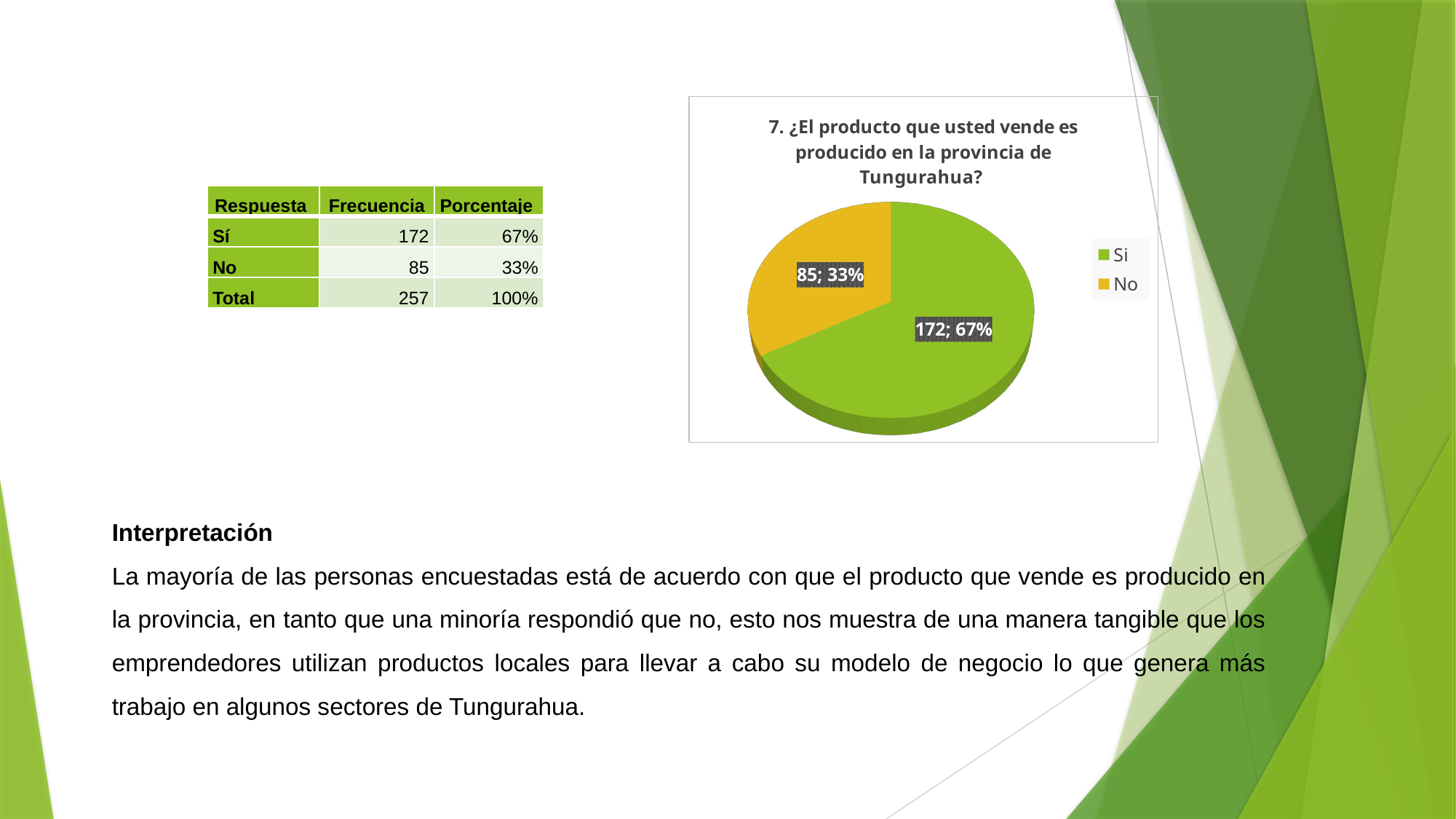
What share of the pie does the 'No' slice represent? 33% What kind of chart is shown on the slide? Pie chart How many slices does the pie chart have? 2 How many entries does the legend of the pie chart list? 2 Which slice of the pie chart is the smallest? No What share of the pie does the 'Si' slice represent? 67% Which slice of the pie chart is the largest? Si What is the frequency value shown for the 'Si' slice in the pie chart? 172 What is the frequency value shown for the 'No' slice in the pie chart? 85 What is the difference in frequency between the 'Si' and 'No' slices? 87 Which colour represents the 'No' slice in the pie chart? Orange/yellow What is the title of the pie chart? 7. ¿El producto que usted vende es producido en la provincia de Tungurahua?